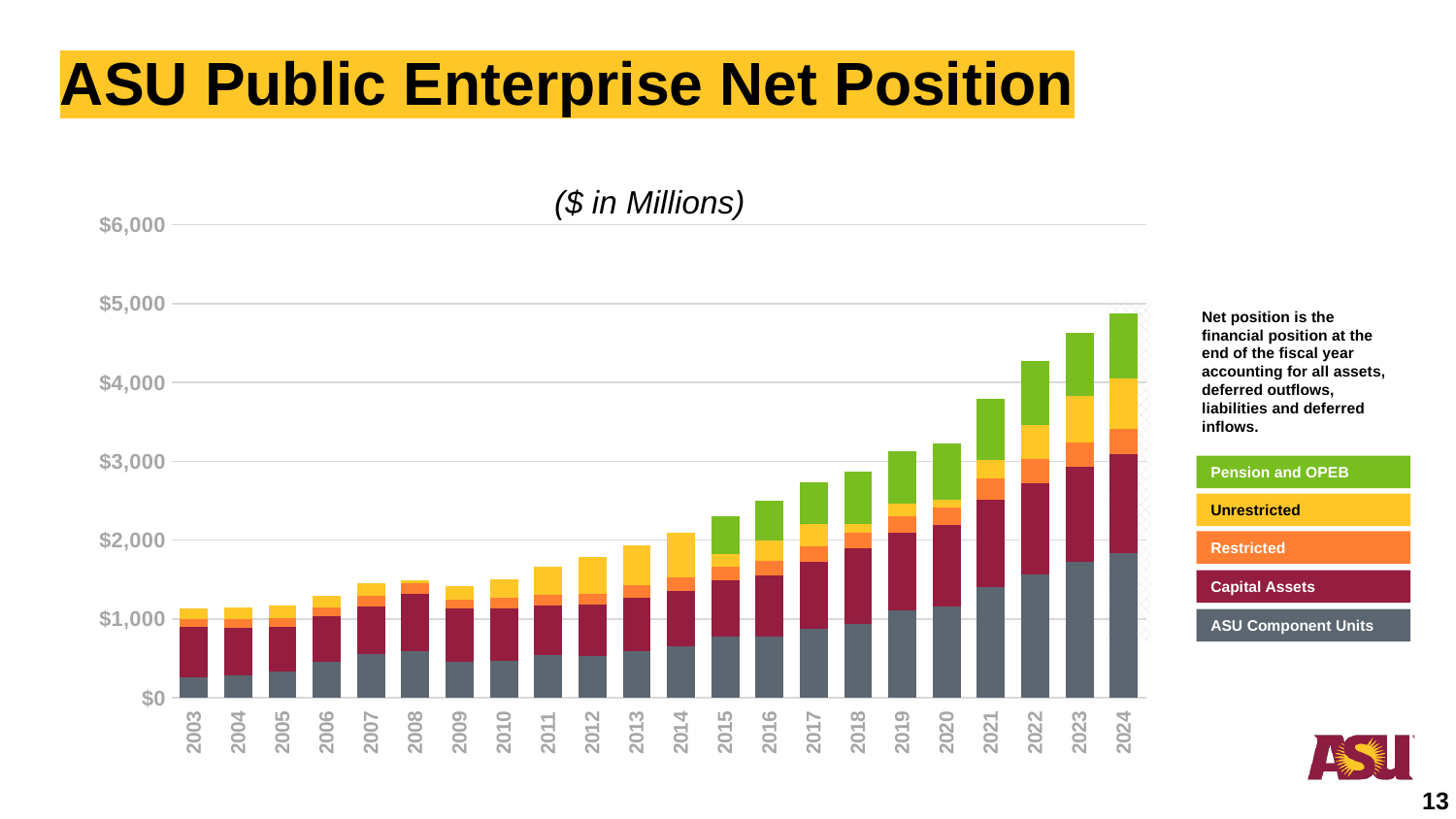
Which year has the highest total net position in the chart? 2024 Which series is shown in green in the chart's legend? Pension and OPEB How many series does the chart's legend list? 5 Is the total net position for 2021 greater or less than $3,000? greater Is the total net position for 2010 greater or less than $2,000? less Is the total net position for 2015 greater or less than $2,000? greater Does the total net position generally rise or fall from 2003 to 2024? Rise How many years are shown along the x axis of the chart? 22 Which year has the larger total net position, 2019 or 2022? 2022 What unit does the chart's subtitle say the values are in? $ in Millions What kind of chart is shown on the slide? Stacked bar chart